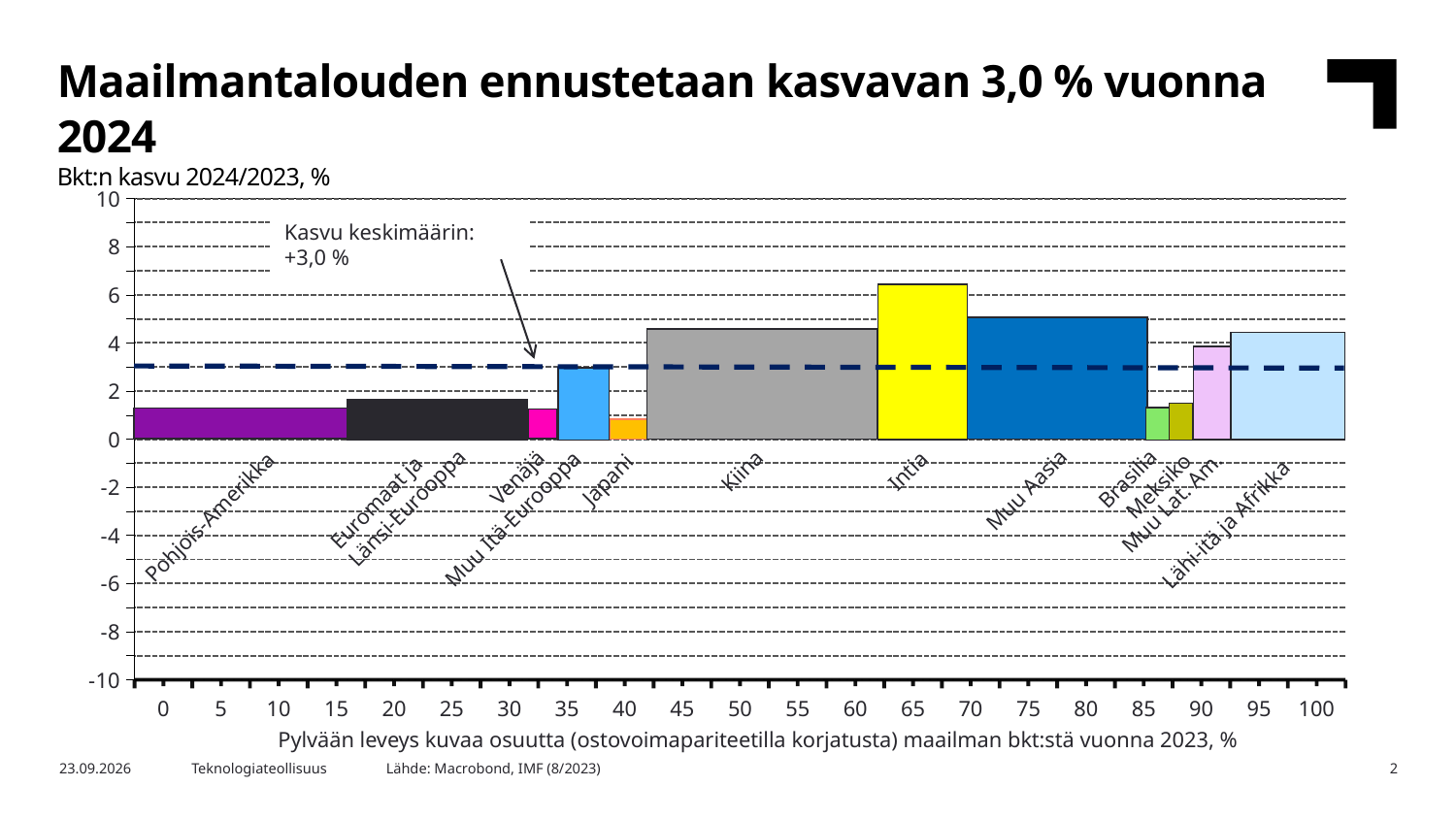
Which has the higher forecast growth, Muu Aasia or Kiina? Muu Aasia What is the label above the chart describing the plotted quantity? Bkt:n kasvu 2024/2023, % What kind of chart is shown on the slide? Bar chart What is the average growth (Kasvu keskimäärin) indicated by the dashed line? +3,0 % What does the width of each bar represent, according to the note below the x axis? Share of (purchasing-power-parity adjusted) world GDP in 2023, % Is the value for Kiina greater or less than 4? greater Which region has the highest forecast GDP growth in the chart? Intia Is the value for Intia greater or less than 6? greater Is the value for Muu Lat. Am greater or less than 2? greater How many regions (bars) are shown in the chart? 12 Which has the higher forecast growth, Intia or Kiina? Intia